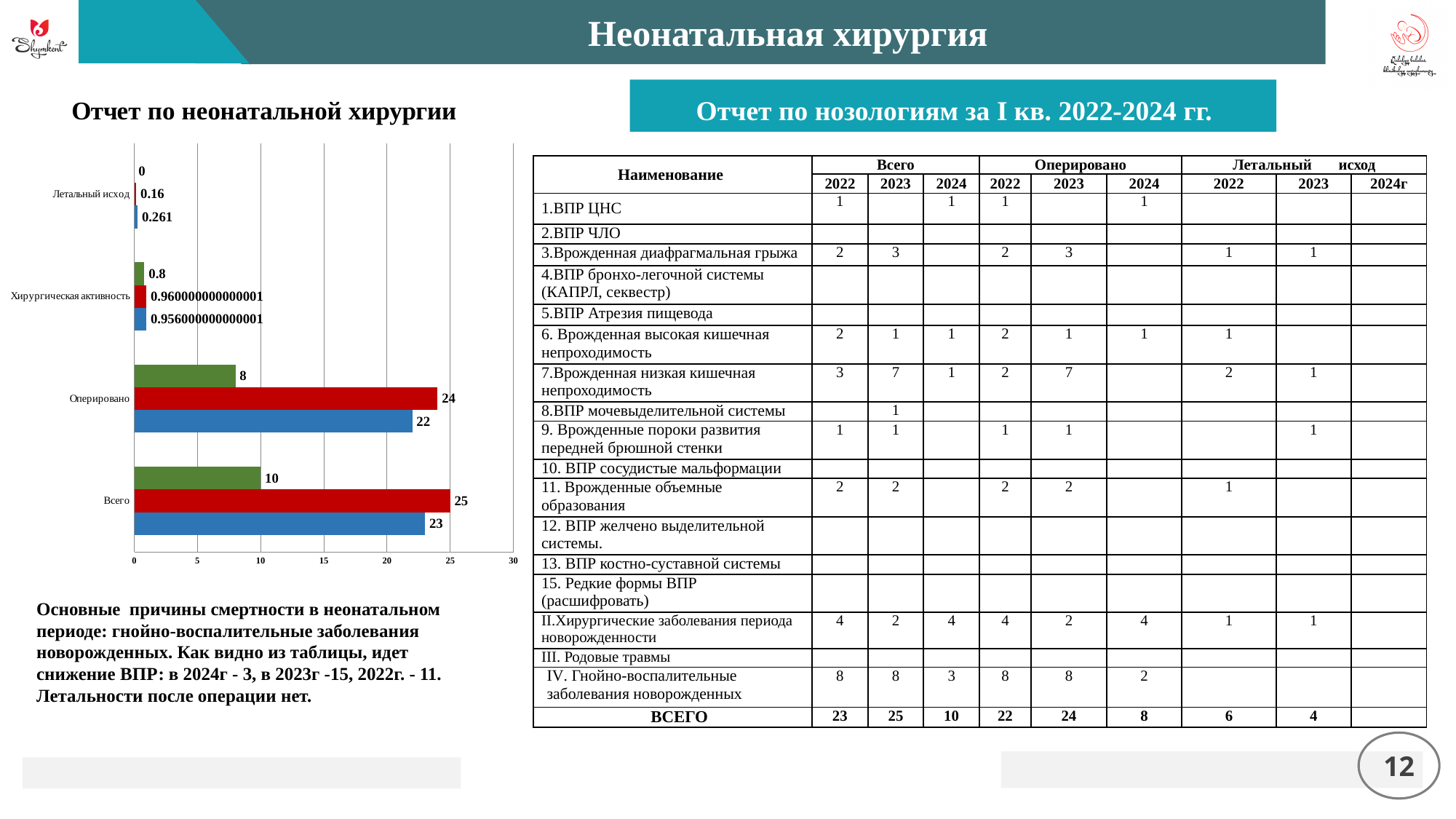
How many bars are plotted for each category in the bar chart? 3 What is the value of the red bar for Оперировано in the bar chart? 24 What is the value of the green bar for Всего in the bar chart? 10 How many categories are shown on the vertical axis of the bar chart? 4 What is the difference between the red and blue bars for Всего in the bar chart? 2 What is the difference between the red and green bars for Оперировано in the bar chart? 16 What is the value of the green bar for Летальный исход in the bar chart? 0 What kind of chart is shown on the left of the slide? bar chart What is the value of the blue bar for Летальный исход in the bar chart? 0.261 What is the value of the blue bar for Всего in the bar chart? 23 Which colour bar is the highest for the Всего category in the bar chart? red Is the value of the red bar for Всего greater or less than 20? greater